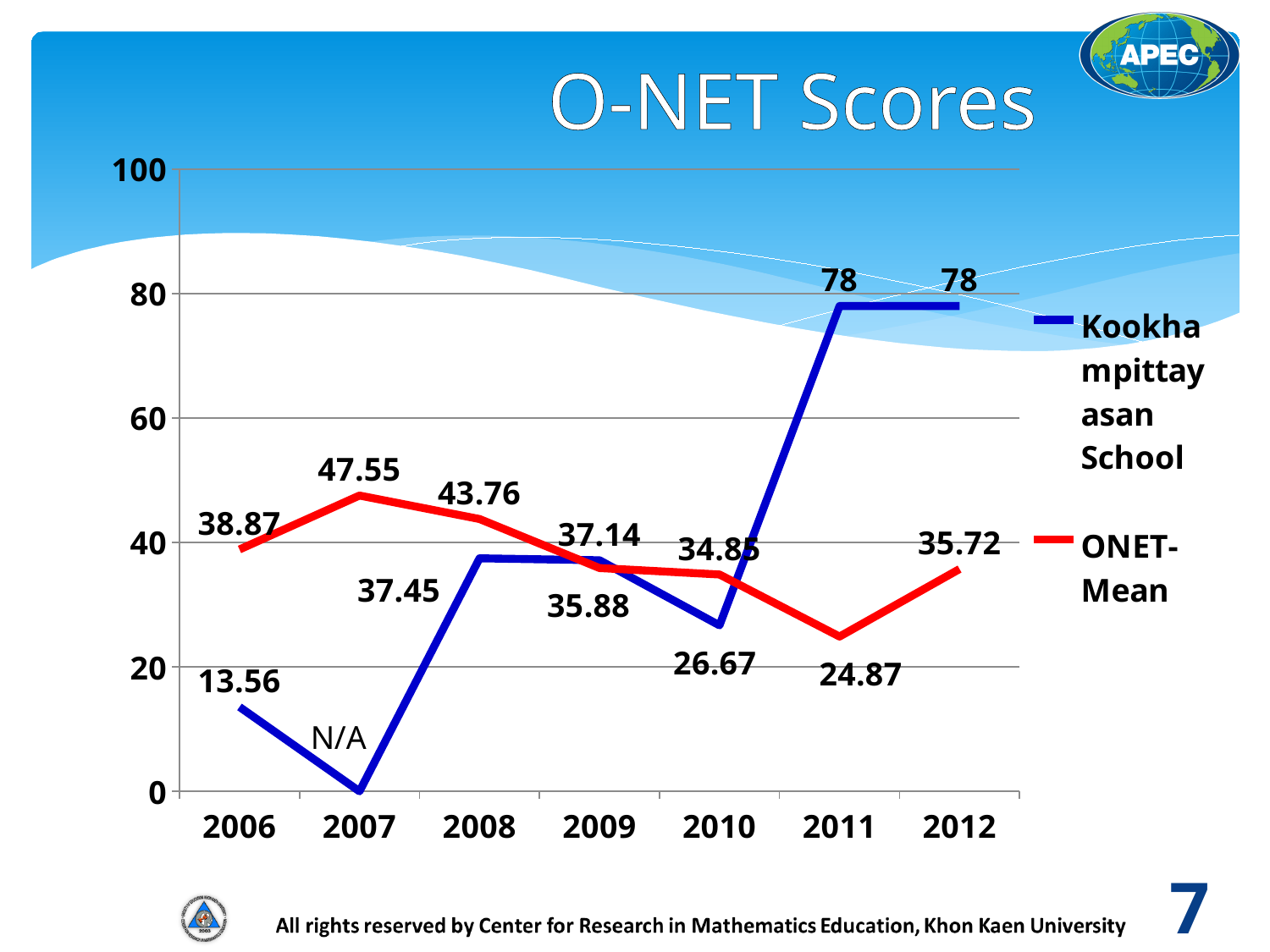
How many years are shown on the x axis? 7 What is the Kookhampittayasan School score in 2011? 78 In which year is the ONET-Mean value highest? 2007 What kind of chart is shown on the slide? line chart In which year is the ONET-Mean value lowest? 2011 What is the difference between the Kookhampittayasan School score and the ONET-Mean in 2011? 53.13 How many series does the legend list? 2 What is the title of the chart? O-NET Scores What is the Kookhampittayasan School score in 2006? 13.56 What is the ONET-Mean value in 2012? 35.72 What is the ONET-Mean value in 2007? 47.55 Which is larger in 2010, the Kookhampittayasan School score or the ONET-Mean? ONET-Mean